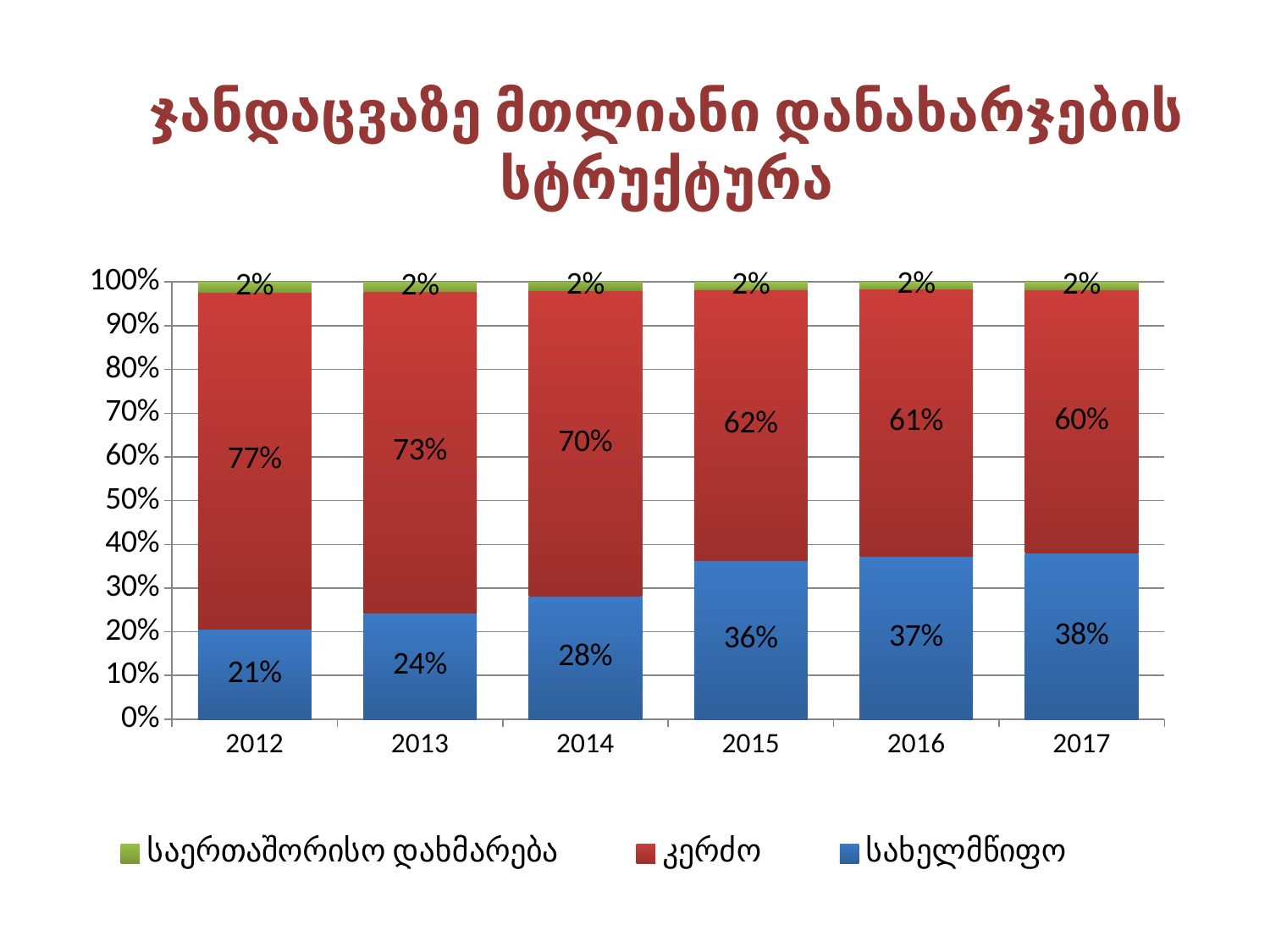
Does the სახელმწიფო share rise or fall from 2012 to 2017? Rise What is the value for კერძო in 2017? 60% Which is larger in 2015: the სახელმწიფო share or the კერძო share? კერძო What is the value for სახელმწიფო in 2012? 21% How many years are shown on the x axis? 6 In which year is the სახელმწიფო share highest? 2017 What is the value for კერძო in 2014? 70% What kind of chart is shown on the slide? Stacked bar chart What is the difference between the კერძო share in 2012 and in 2017? 17% In which year is the კერძო share lowest? 2017 How many series does the legend list? 3 What is the value for საერთაშორისო დახმარება in 2016? 2%